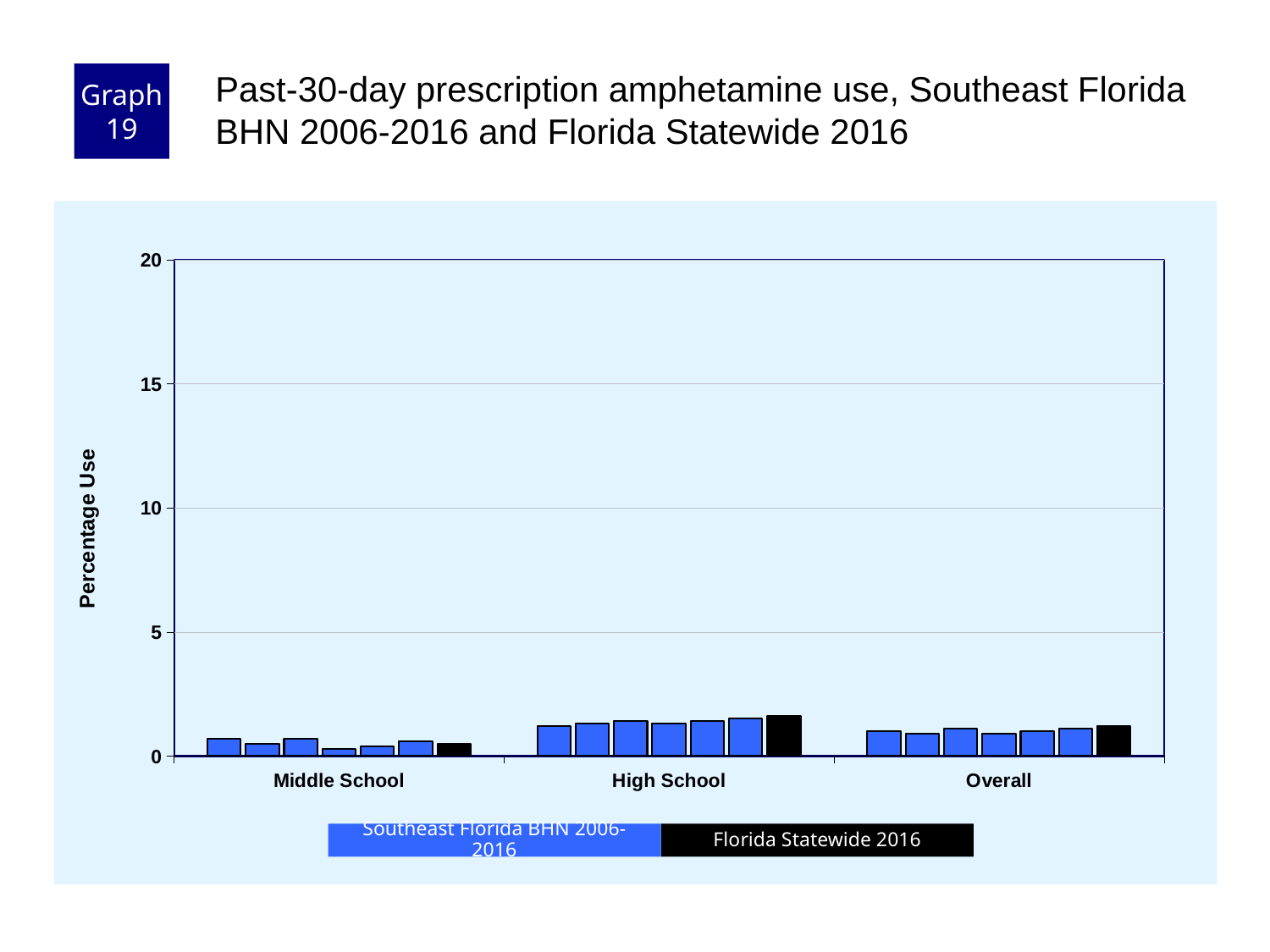
How many series does the legend list? 2 Which school-level category has the highest Florida Statewide 2016 value? High School Is the Florida Statewide 2016 value for Overall greater or less than 10? less Is the Florida Statewide 2016 value for High School greater or less than 5? less How many bars are plotted in the High School group? 7 How many school-level categories are shown on the x axis? 3 What kind of chart is shown on the slide? bar chart Which series is shown in black in the legend? Florida Statewide 2016 For Florida Statewide 2016, is the value for High School or Middle School larger? High School Is the Florida Statewide 2016 value for Middle School greater or less than 5? less Which school-level category has the lowest Florida Statewide 2016 value? Middle School What is the label of the y axis? Percentage Use